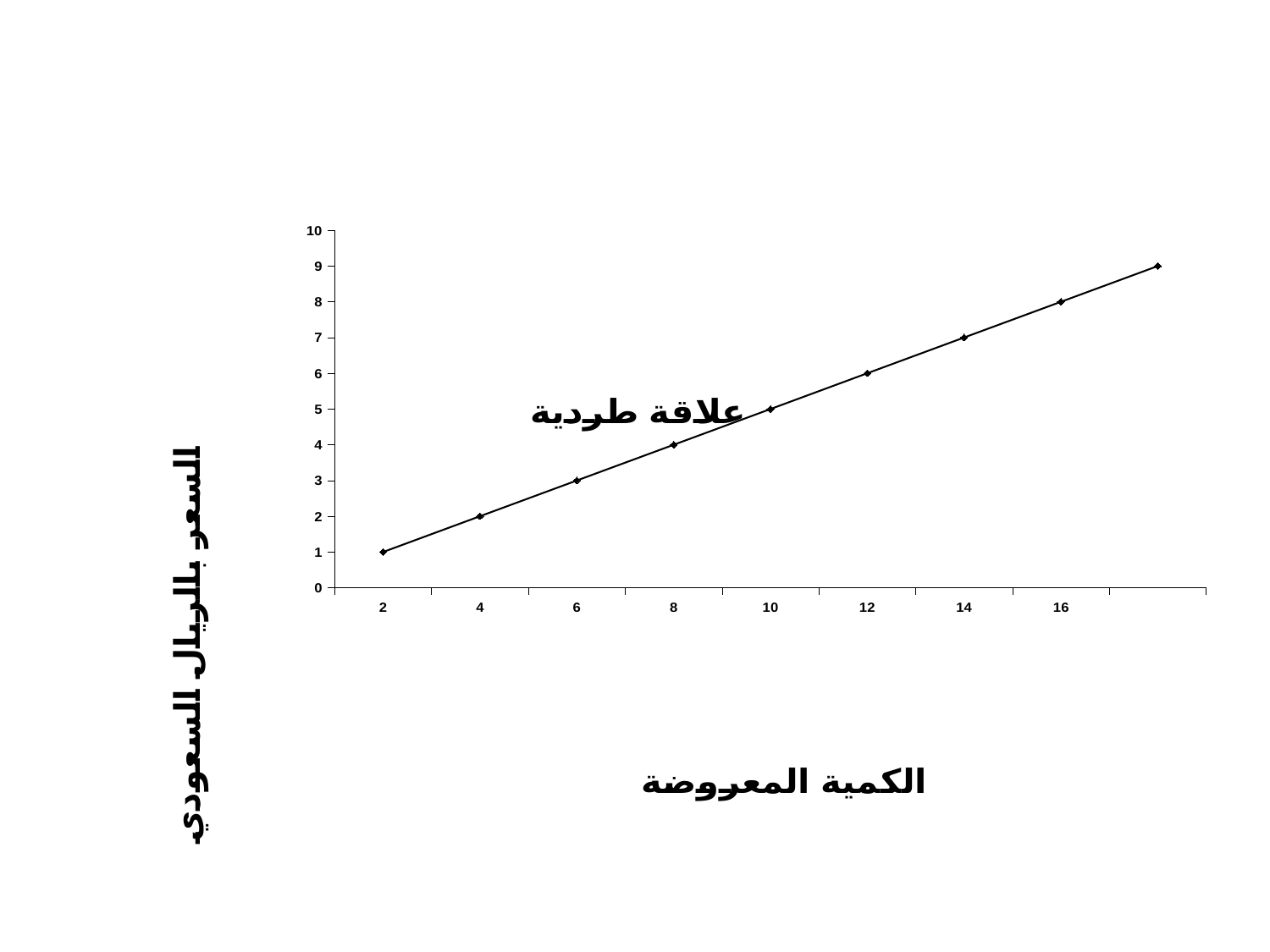
What is the difference between the plotted values at x = 12 and x = 4? 4 Do the plotted values rise or fall as the x axis increases? rise What kind of chart is shown on the slide? line chart What is the value on the y axis when the quantity supplied (x axis) is 16? 8 What is the value on the y axis when the quantity supplied (x axis) is 10? 5 What is the value on the y axis when the quantity supplied (x axis) is 6? 3 What text label is written on the chart next to the line? علاقة طردية How many data points are plotted on the line? 9 At which labelled x-axis value is the plotted value lowest? 2 At which labelled x-axis value is the plotted value highest? 16 What is the value on the y axis when the quantity supplied (x axis) is 2? 1 Which is larger, the plotted value at x = 8 or at x = 14? x = 14